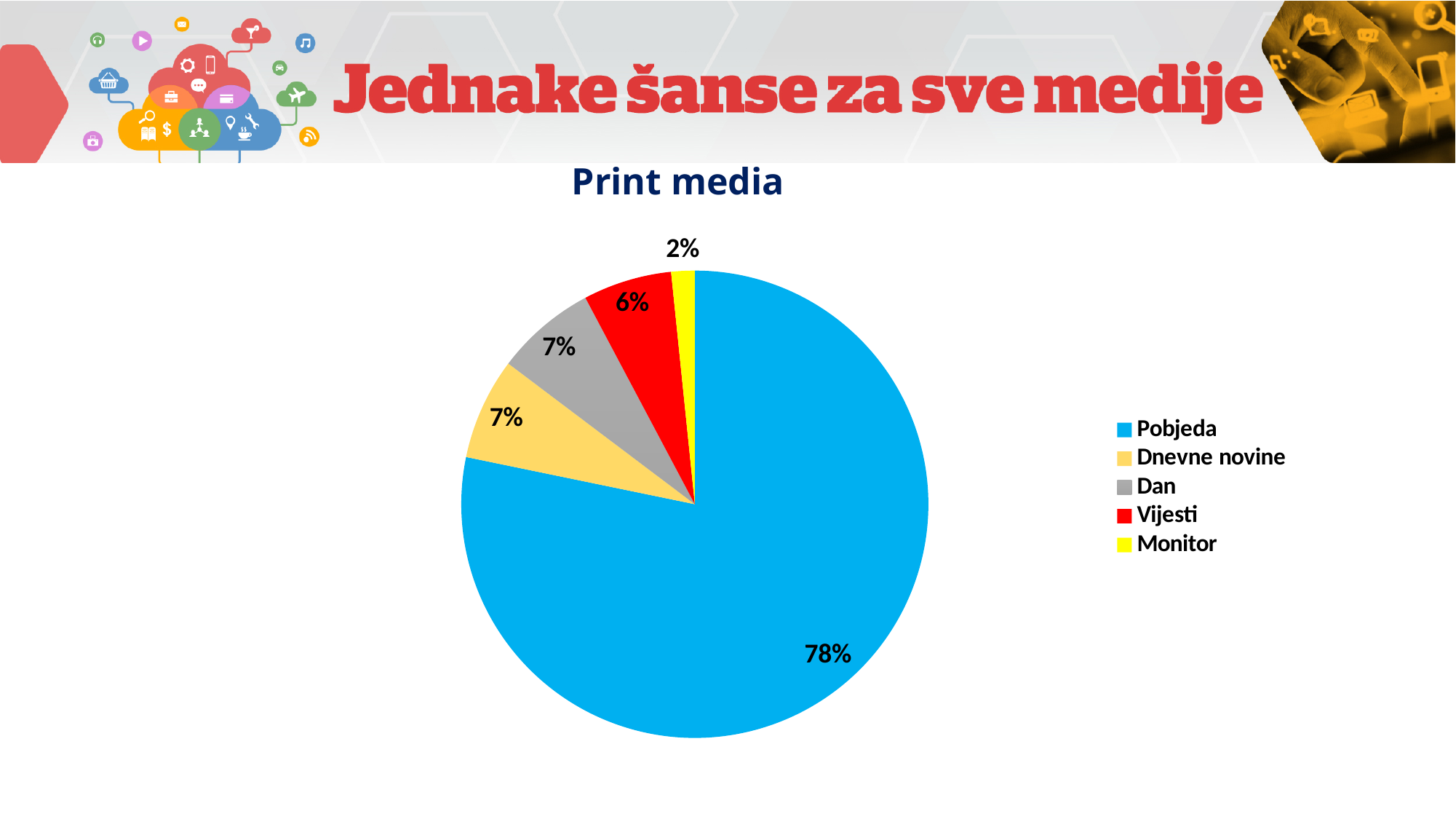
What is the difference between the values for Pobjeda and Vijesti? 72% How many categories does the legend list? 5 What share of the pie does Pobjeda have? 78% Which is larger, the value for Vijesti or the value for Monitor? Vijesti What is the title of the chart? Print media What is the value shown for Vijesti? 6% What is the value shown for Monitor? 2% Which category has the largest slice of the pie? Pobjeda What colour is the slice for Dan? grey What is the value shown for Dan? 7% What kind of chart is shown on the slide? pie chart Which category has the smallest slice of the pie? Monitor